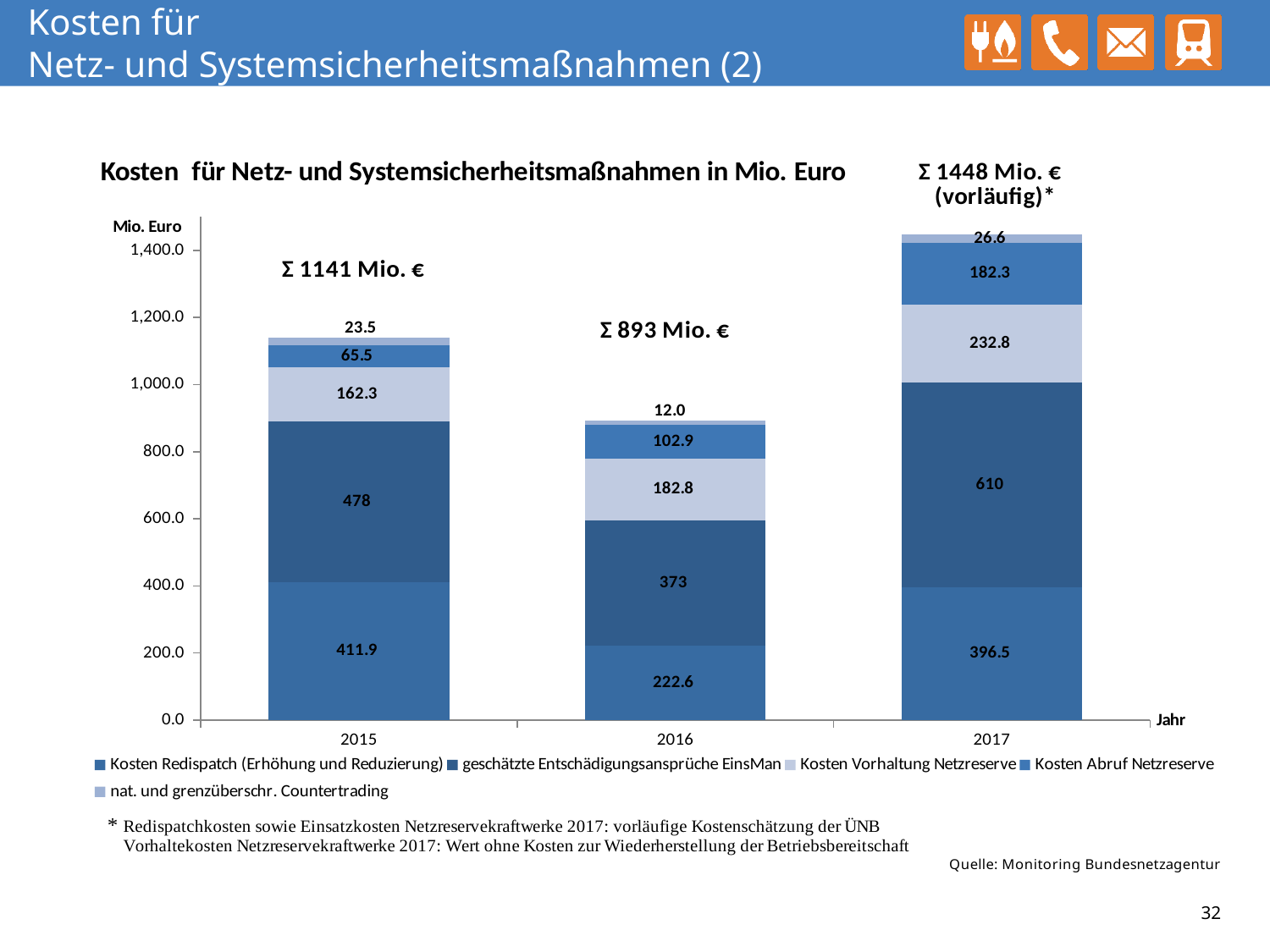
Which year has the highest total cost? 2017 Which is larger: Kosten Redispatch (Erhöhung und Reduzierung) in 2015 or in 2017? 2015 Which year has the lowest total cost? 2016 How many series does the legend list? 5 What is the value for geschätzte Entschädigungsansprüche EinsMan in 2017? 610 What is the difference between the Kosten Abruf Netzreserve values for 2017 and 2015? 116.8 What is the value for Kosten Redispatch (Erhöhung und Reduzierung) in 2015? 411.9 What is the total of the stacked bar for 2016 as shown on the slide? Σ 893 Mio. € What is the value for Kosten Vorhaltung Netzreserve in 2016? 182.8 How many years are shown on the x axis? 3 What kind of chart is shown on the slide? Stacked bar chart What is the value for nat. und grenzüberschr. Countertrading in 2016? 12.0